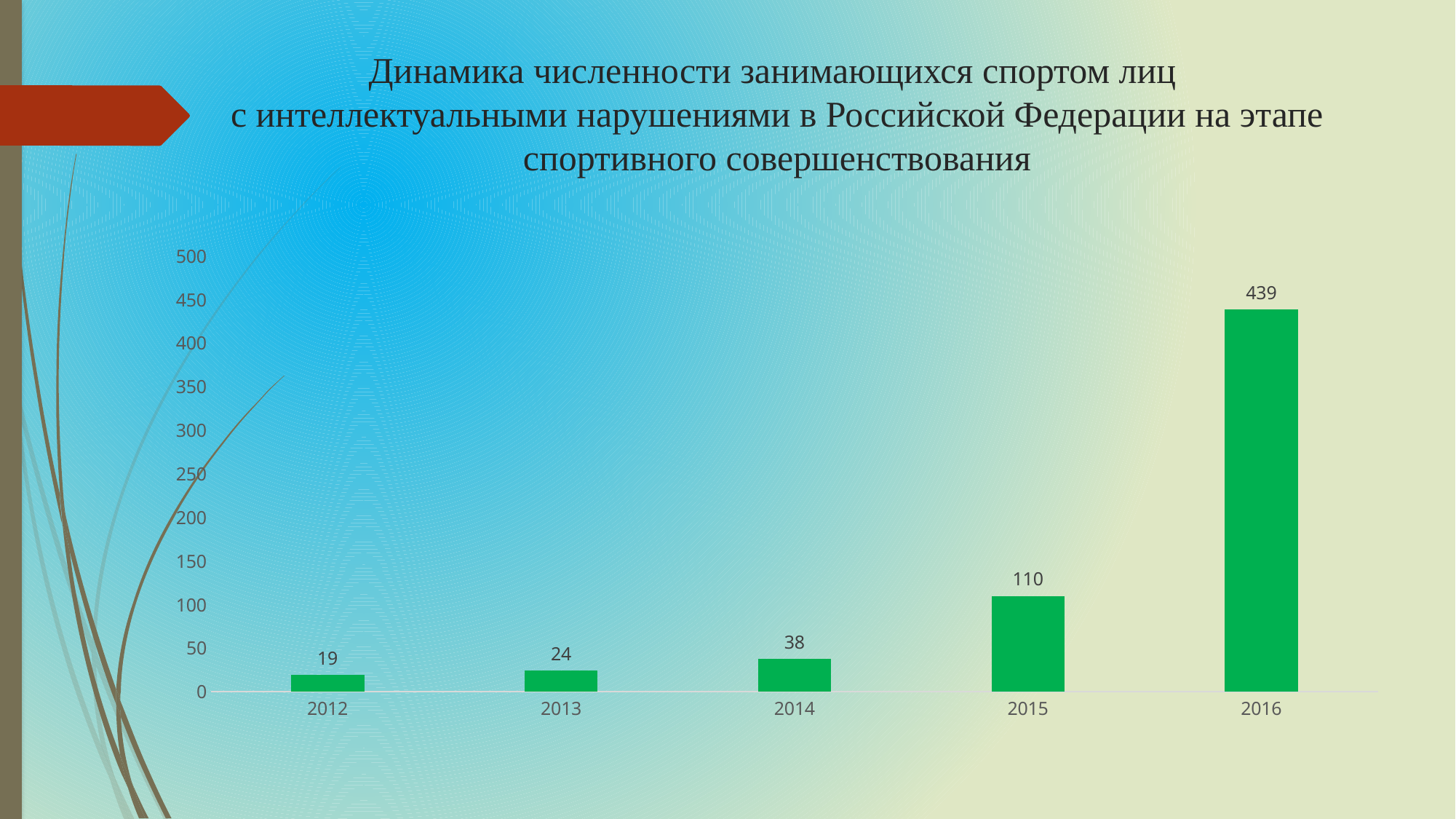
What is the value for 2014? 38 What is the value for 2012? 19 Which year has the lowest value? 2012 What is the value for 2016? 439 What is the difference between the values for 2016 and 2015? 329 What is the difference between the values for 2013 and 2012? 5 Which year has the highest value? 2016 Is the value for 2015 greater or less than 100? greater How many years are shown on the x axis? 5 Do the values rise or fall from 2012 to 2016? rise Which is larger, the value for 2014 or the value for 2015? 2015 What kind of chart is shown on the slide? bar chart